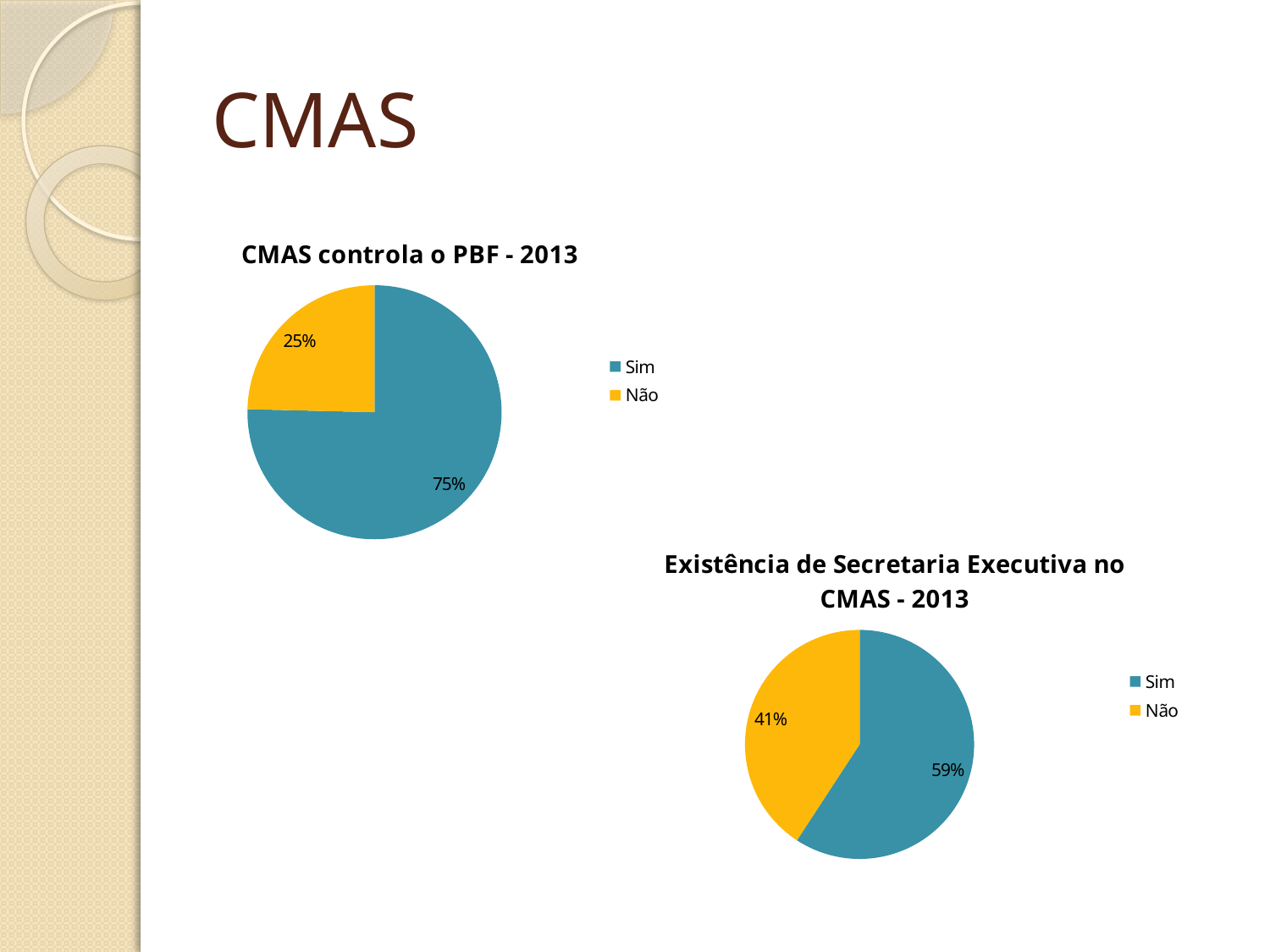
How many slices does the chart 'Existência de Secretaria Executiva no CMAS - 2013' have? 2 In the chart 'Existência de Secretaria Executiva no CMAS - 2013', what is the difference in percentage points between 'Sim' and 'Não'? 18 In the chart 'CMAS controla o PBF - 2013', what colour is the 'Não' slice? Yellow/orange In the chart 'CMAS controla o PBF - 2013', what share of the pie is 'Sim'? 75% In the chart 'CMAS controla o PBF - 2013', which slice is the largest? Sim In the chart 'CMAS controla o PBF - 2013', what is the difference in percentage points between 'Sim' and 'Não'? 50 In the chart 'Existência de Secretaria Executiva no CMAS - 2013', what share of the pie is 'Sim'? 59% Which is larger: the 'Sim' share in 'CMAS controla o PBF - 2013' or the 'Sim' share in 'Existência de Secretaria Executiva no CMAS - 2013'? CMAS controla o PBF - 2013 In the chart 'Existência de Secretaria Executiva no CMAS - 2013', which slice is the smallest? Não In the chart 'Existência de Secretaria Executiva no CMAS - 2013', what share of the pie is 'Não'? 41% What type of chart is 'CMAS controla o PBF - 2013'? Pie chart